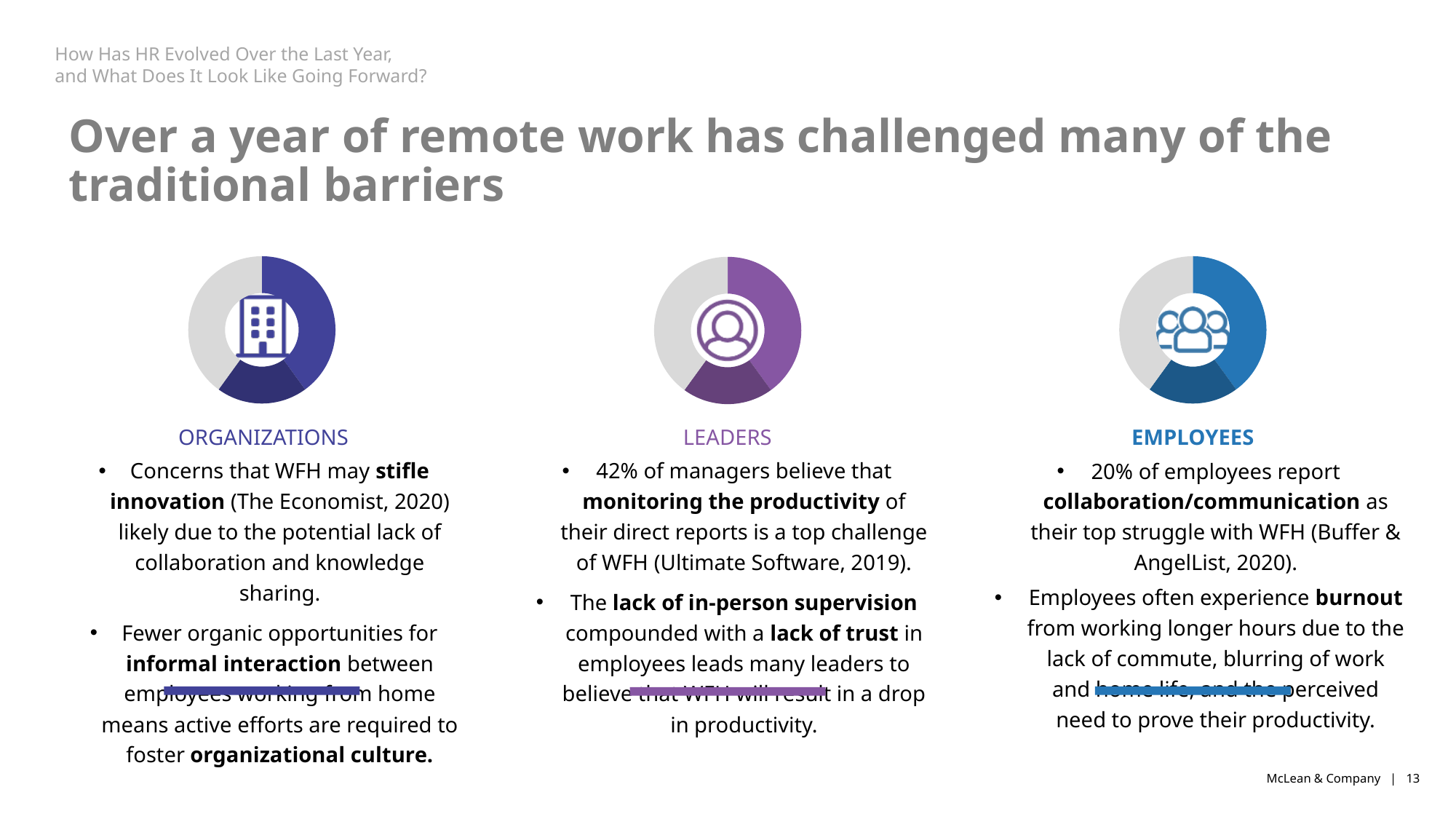
In the donut chart above the ORGANIZATIONS heading, is the grey segment larger or smaller than the small dark-purple segment at the bottom? Larger How many donut charts are shown on the slide? 3 In the donut chart above the LEADERS heading, what colour is the largest coloured (non-grey) segment? Purple What kind of chart is shown above the ORGANIZATIONS heading? Donut (pie) chart How many segments does the donut chart above the EMPLOYEES heading have? 3 In the donut chart above the EMPLOYEES heading, what colour is the largest coloured (non-grey) segment? Blue In the donut chart above the LEADERS heading, which segment is the smallest: the purple, the dark purple at the bottom, or the grey? The dark purple at the bottom What kind of chart is shown above the LEADERS heading? Donut (pie) chart